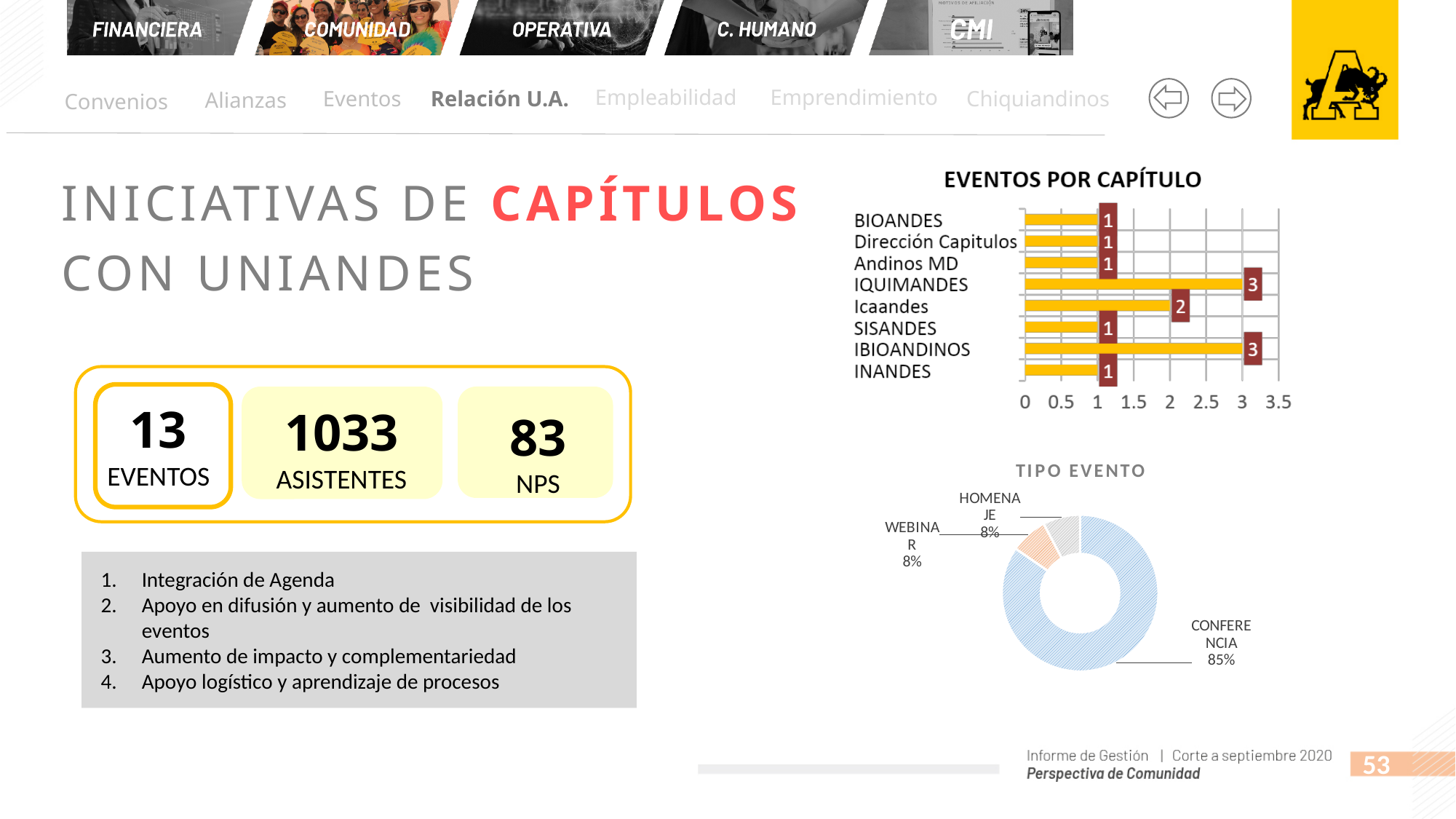
In the 'EVENTOS POR CAPÍTULO' chart, what is the value for INANDES? 1 How many slices are shown in the 'TIPO EVENTO' chart? 3 What kind of chart is 'EVENTOS POR CAPÍTULO'? bar chart How many categories are shown in the 'EVENTOS POR CAPÍTULO' chart? 8 In the 'TIPO EVENTO' chart, what share does WEBINAR have? 8% In the 'EVENTOS POR CAPÍTULO' chart, what is the value for IQUIMANDES? 3 In the 'EVENTOS POR CAPÍTULO' chart, which has the larger value, IBIOANDINOS or SISANDES? IBIOANDINOS In the 'EVENTOS POR CAPÍTULO' chart, what is the difference between the values for IQUIMANDES and Icaandes? 1 In the 'TIPO EVENTO' chart, which event type has the largest share? CONFERENCIA What kind of chart is 'TIPO EVENTO'? doughnut chart In the 'TIPO EVENTO' chart, what share does CONFERENCIA have? 85% In the 'EVENTOS POR CAPÍTULO' chart, what is the value for Icaandes? 2